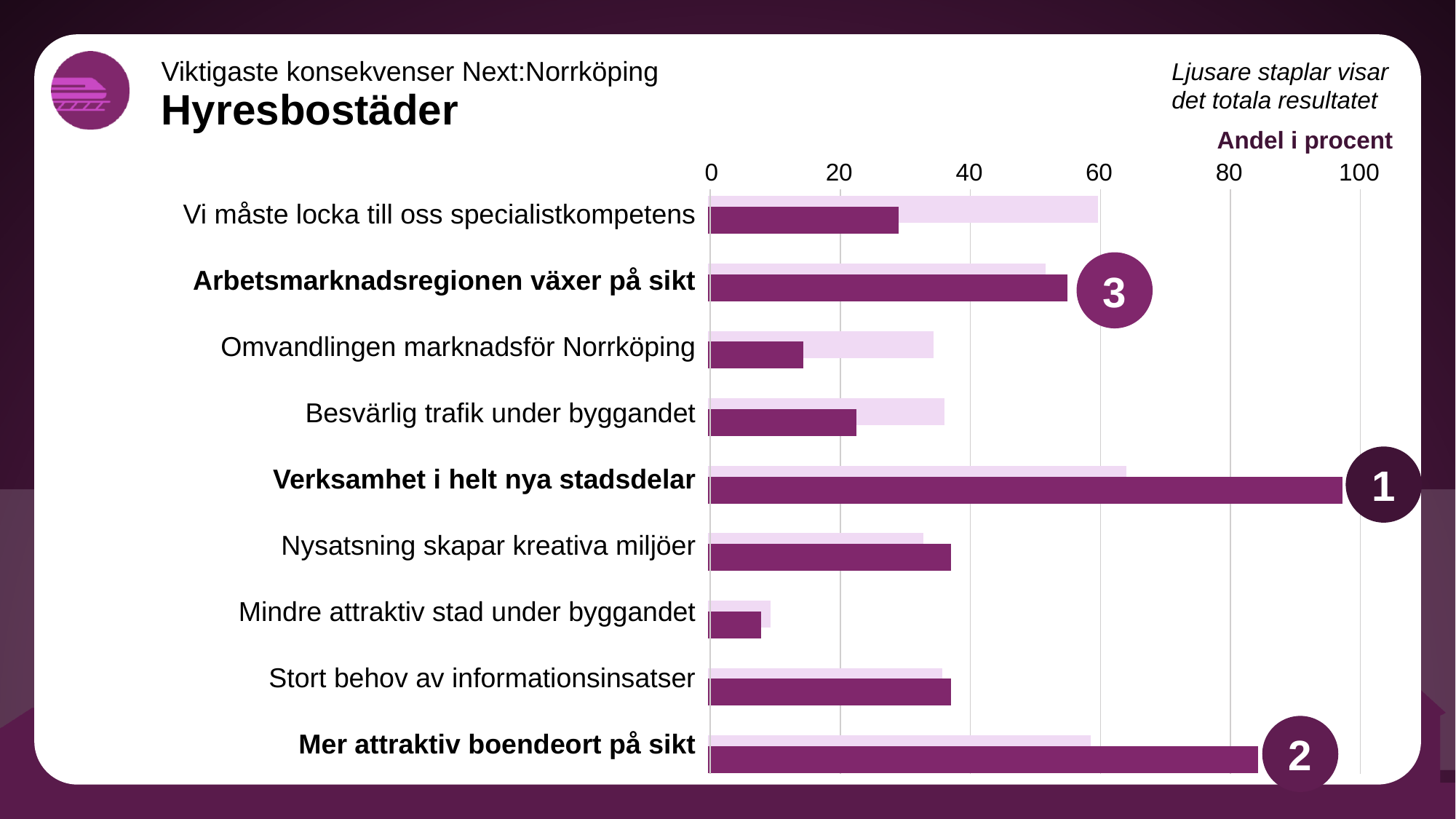
How many categories (consequences) are listed on the chart? 9 Is the dark bar value for 'Verksamhet i helt nya stadsdelar' greater or less than 80? greater Is the dark bar value for 'Omvandlingen marknadsför Norrköping' greater or less than 20? less Is the light bar value for 'Vi måste locka till oss specialistkompetens' greater or less than 40? greater Which category has the longest dark bar? Verksamhet i helt nya stadsdelar According to the note on the slide, what do the lighter bars show? det totala resultatet Which category has the shortest dark bar? Mindre attraktiv stad under byggandet Which has the larger dark bar: 'Mer attraktiv boendeort på sikt' or 'Arbetsmarknadsregionen växer på sikt'? Mer attraktiv boendeort på sikt What kind of chart is shown on the slide? bar chart What is the unit label shown above the chart's axis? Andel i procent